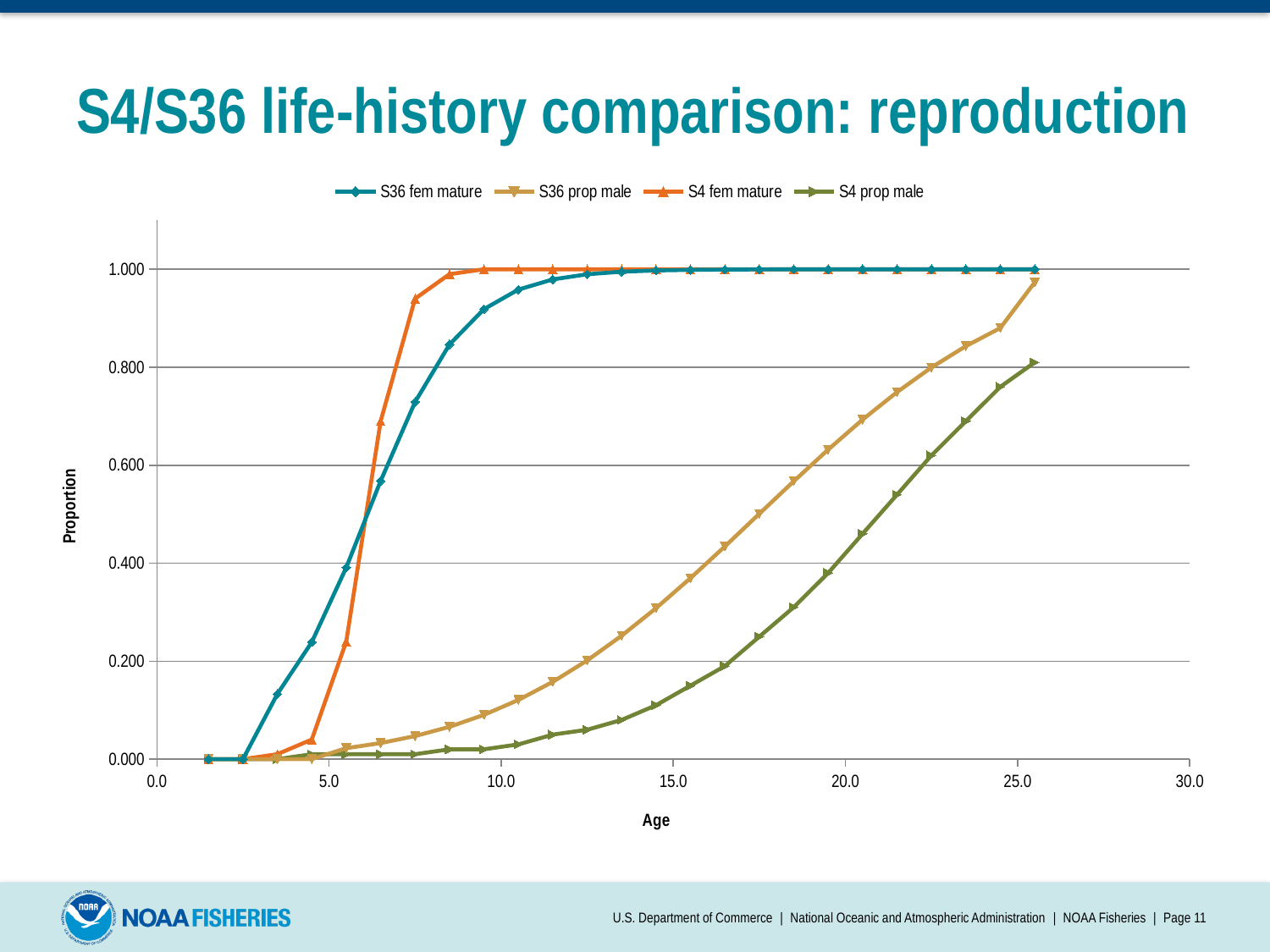
At age 20, which series has the higher value: S36 prop male or S4 prop male? S36 prop male What is the title of the chart's horizontal axis? Age How many series does the legend list? 4 Is the value for S36 fem mature at age 10 greater or less than 0.800? greater At age 10, which series has the higher value: S4 fem mature or S36 fem mature? S4 fem mature Which series has the lowest value at age 25? S4 prop male What is the title of the chart's vertical axis? Proportion What kind of chart is shown on the slide? line chart Does the S4 prop male series rise or fall as age increases? rise Is the value for S4 prop male at age 15 greater or less than 0.200? less Is the value for S4 prop male at age 25 greater or less than 0.600? greater